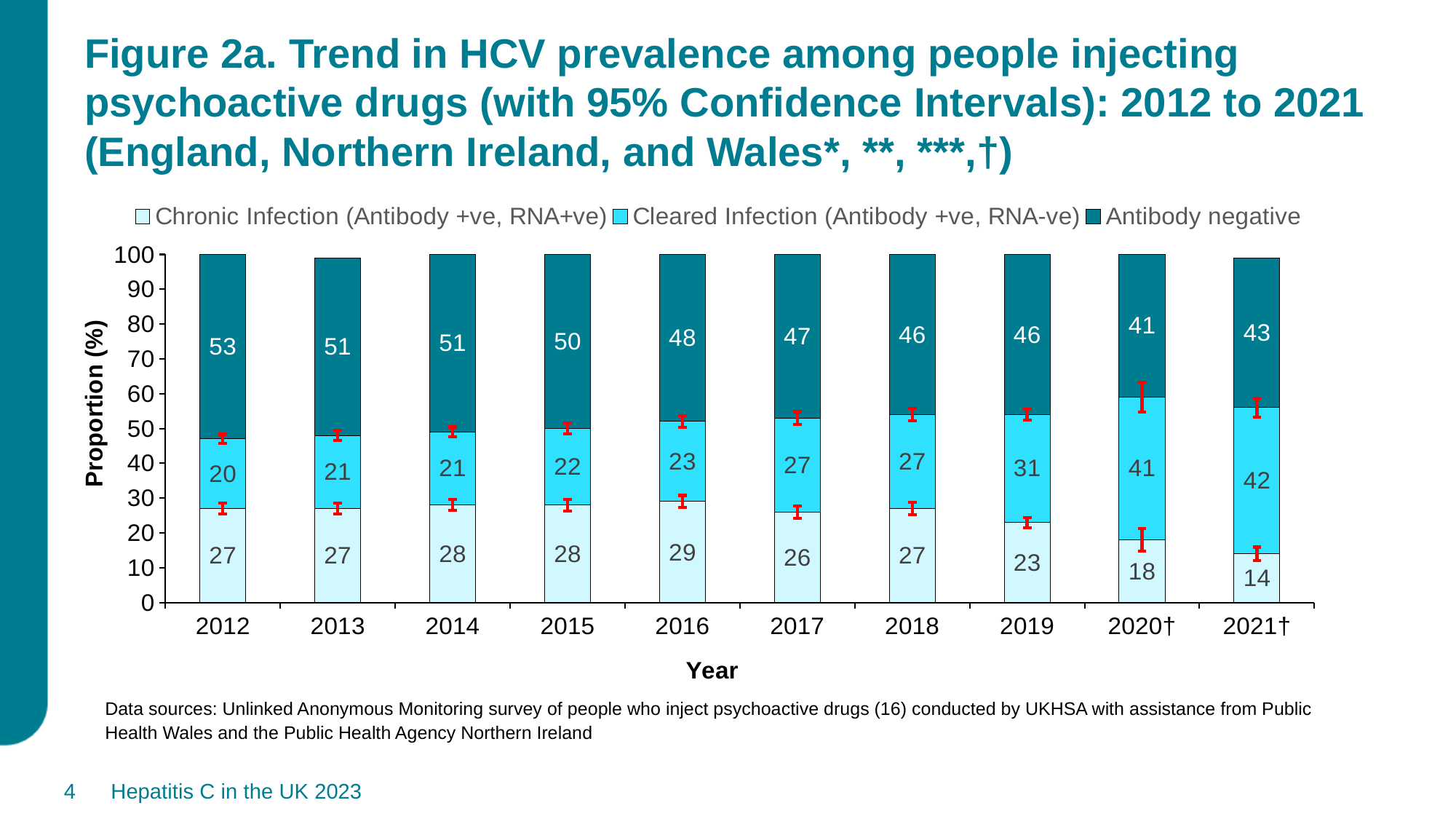
Which is larger, the Cleared Infection value for 2017 or the Chronic Infection value for 2017? Cleared Infection (27) What is the total of the stacked bar for 2012? 100 How many years are shown on the x axis? 10 How many series does the legend list? 3 What kind of chart is shown on the slide? Stacked bar chart In which year is the Chronic Infection (Antibody +ve, RNA+ve) value lowest? 2021† What is the Chronic Infection (Antibody +ve, RNA+ve) value for 2016? 29 What is the Antibody negative value for 2020†? 41 Does the Cleared Infection (Antibody +ve, RNA-ve) value rise or fall from 2012 to 2021†? Rise What is the difference between the Antibody negative values for 2012 and 2021†? 10 In which year is the Cleared Infection (Antibody +ve, RNA-ve) value highest? 2021† What is the Cleared Infection (Antibody +ve, RNA-ve) value for 2019? 31